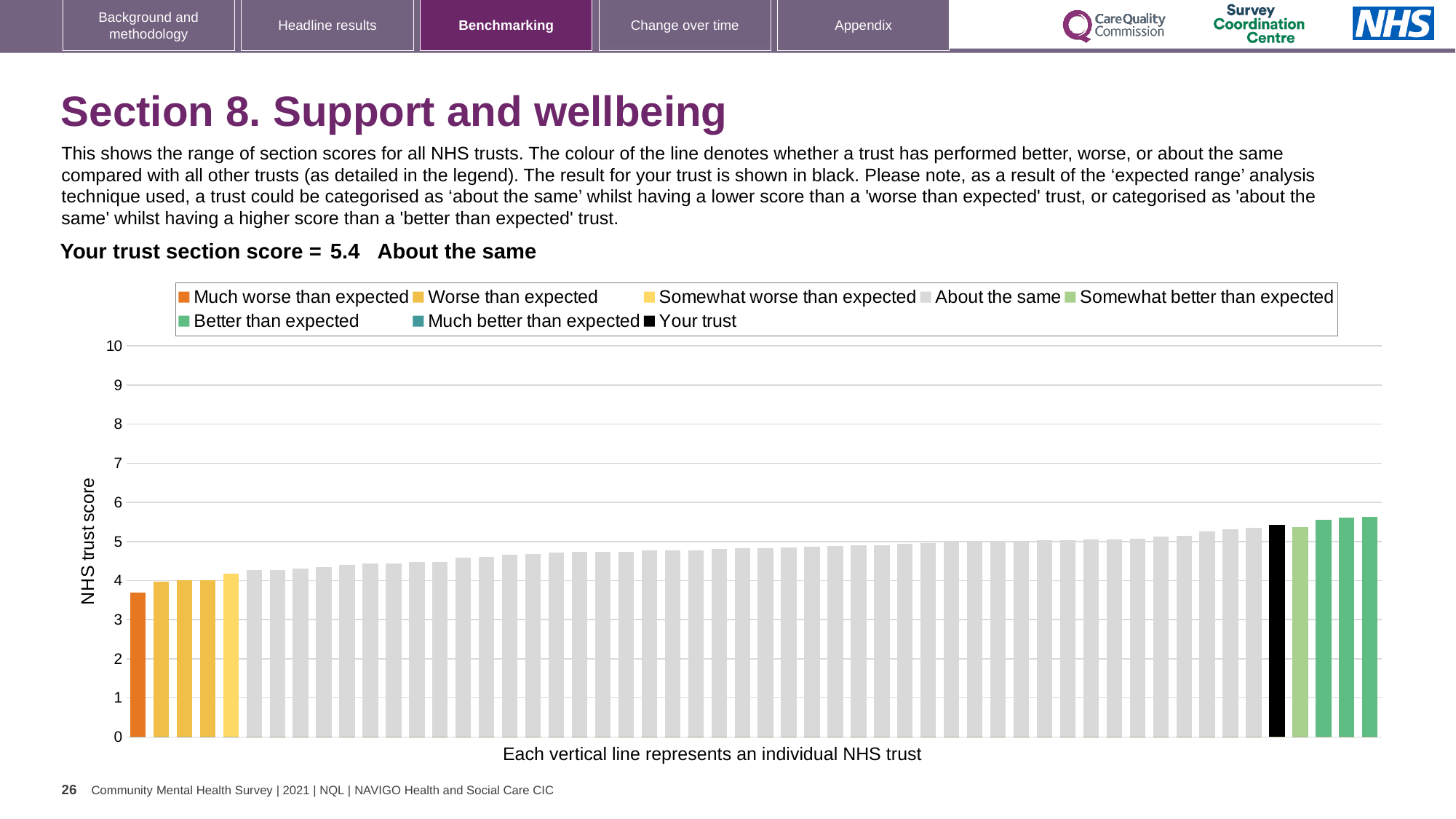
How many series does the legend list? 8 Is the value for the highest-scoring trust greater or less than 5? greater Is the value for the lowest-scoring trust greater or less than 4? less What kind of chart is shown on the slide? bar chart Which benchmarking category is your trust placed in for this section? About the same How many trusts are shown as 'Much worse than expected'? 1 What is the section score for your trust? 5.4 What colour is the bar representing your trust? black Do the trust scores rise or fall from left to right along the x axis? rise Is the value for your trust greater or less than 5? greater How many trusts are shown as 'Much better than expected'? 0 How many trusts are shown as 'Better than expected'? 3